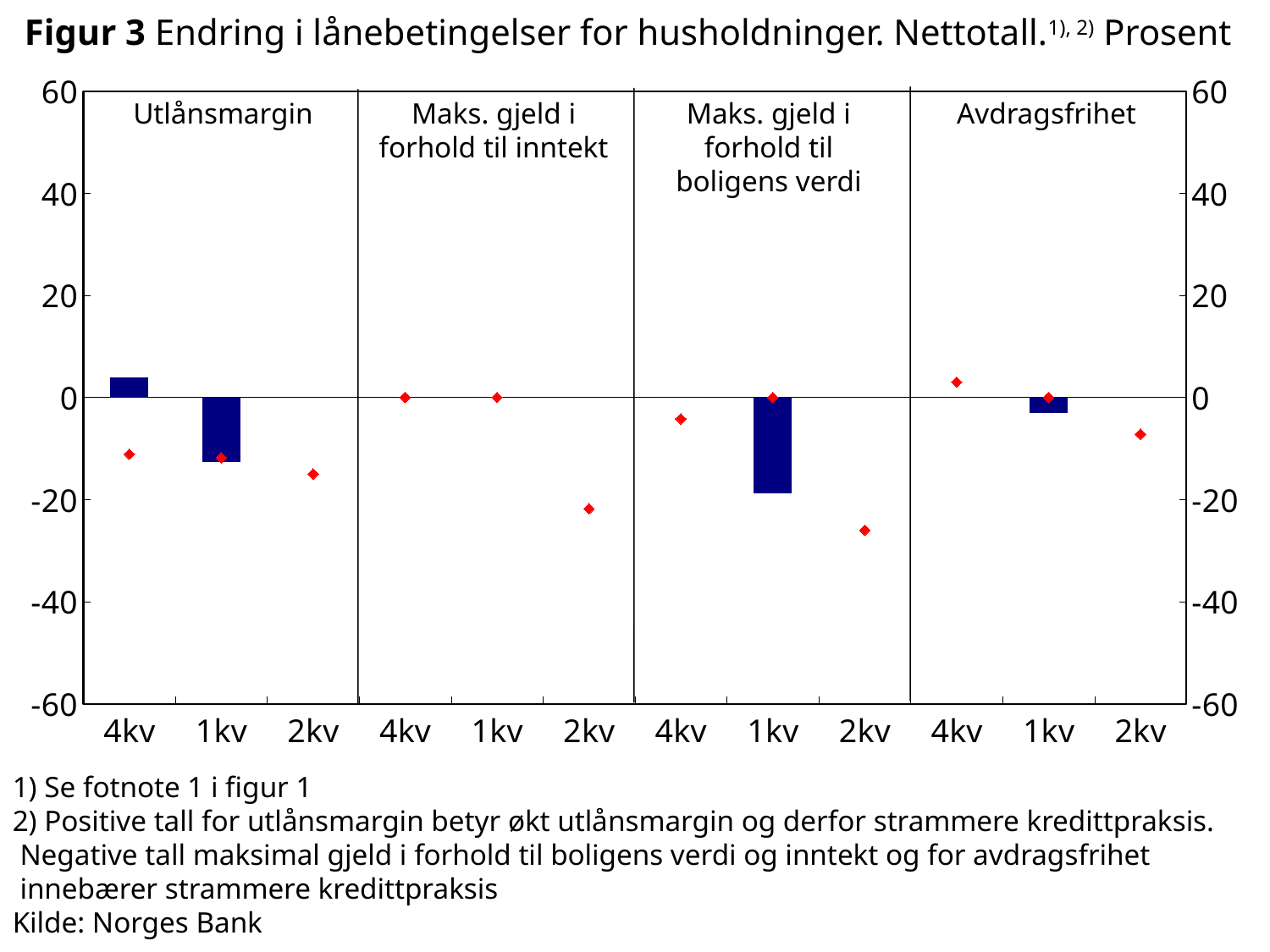
In the Utlånsmargin panel, is the bar for 4kv greater or less than 0? greater How many quarters are shown on the x axis within each panel? 3 In the Utlånsmargin panel, is the bar for 1kv greater or less than -10? less Which panel contains the lowest (most negative) bar? Maks. gjeld i forhold til boligens verdi How many panels (loan-condition categories) does the chart have? 4 In the 'Maks. gjeld i forhold til boligens verdi' panel, is the red marker for 2kv greater or less than -20? less What kind of chart is shown on the slide? combination chart with bars and markers (bar and line chart) In the Avdragsfrihet panel, which red marker is higher, 4kv or 2kv? 4kv In the Avdragsfrihet panel, do the red markers rise or fall from 4kv to 2kv? fall What source is cited for the chart? Norges Bank